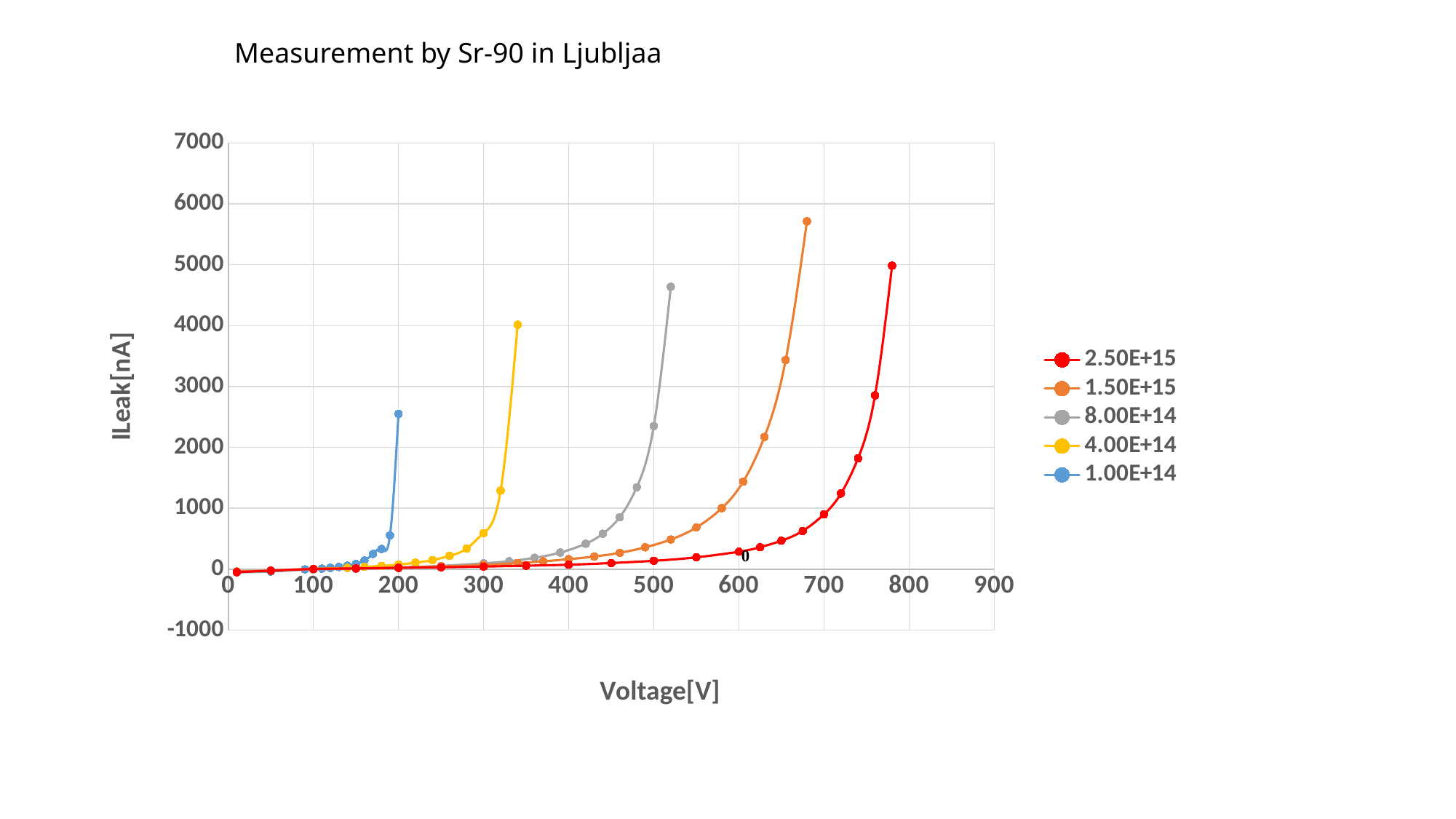
What is the title of the chart? Measurement by Sr-90 in Ljubljaa What is the label of the vertical axis? ILeak[nA] Is the highest ILeak value reached by the 1.00E+14 series greater or less than 2000? greater Is the highest ILeak value reached by the 1.50E+15 series greater or less than 5000? greater Is the highest ILeak value reached by the 4.00E+14 series greater or less than 3000? greater Which series has the lowest peak ILeak value on the chart? 1.00E+14 How many series does the legend list? 5 Which series reaches the highest ILeak value on the chart? 1.50E+15 Which series reaches a higher peak ILeak value, 2.50E+15 or 1.50E+15? 1.50E+15 Do the ILeak values for the 2.50E+15 series rise or fall as voltage increases? rise What kind of chart is shown on the slide? line chart